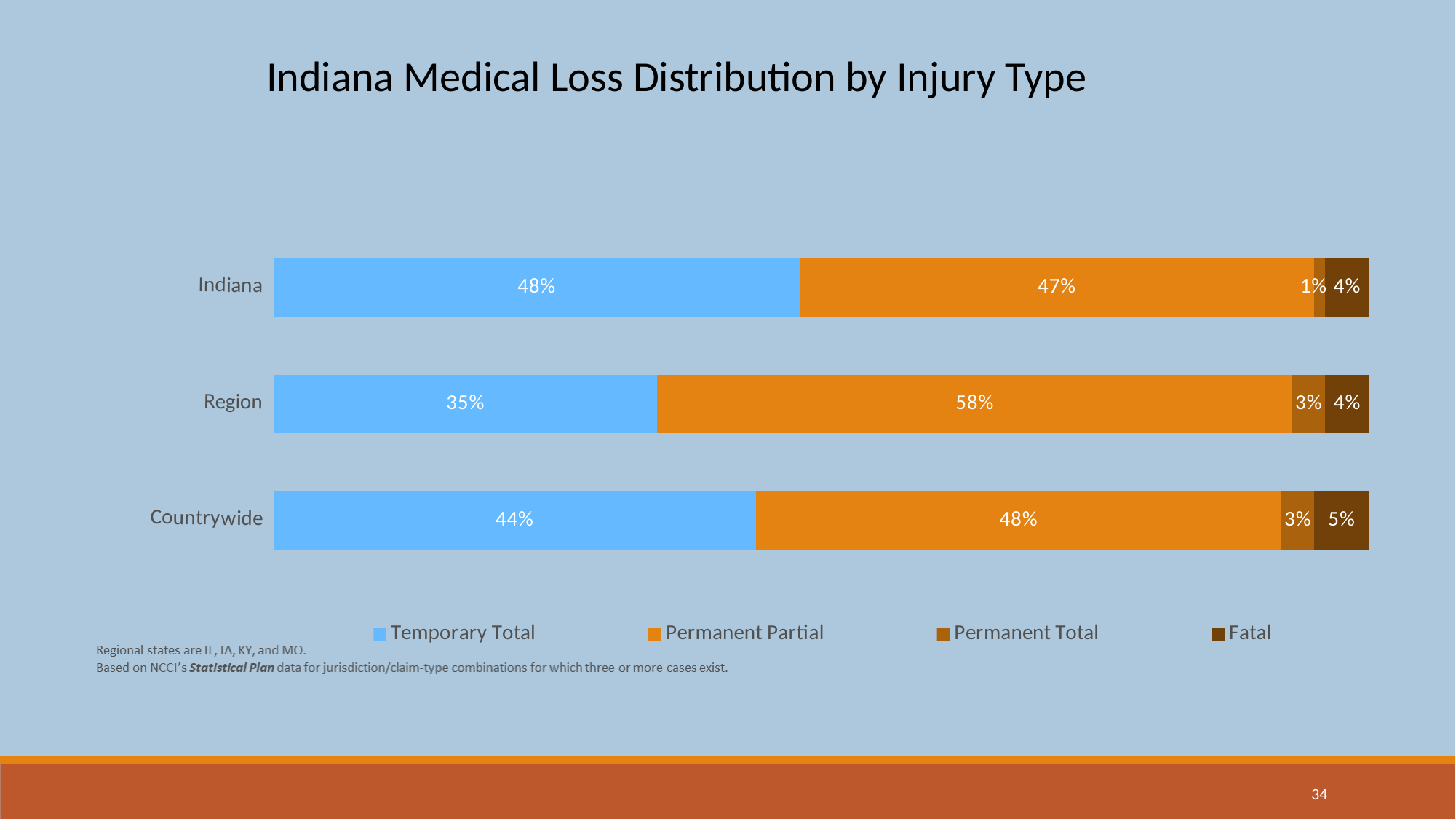
Which is larger, the Permanent Partial share for Indiana or for Countrywide? Countrywide What is the Temporary Total share for Indiana? 48% What is the difference between the Temporary Total shares for Indiana and Region? 13% What is the title of the chart? Indiana Medical Loss Distribution by Injury Type How many series does the legend list? 4 How many categories are shown on the chart? 3 What is the Fatal share for Countrywide? 5% What is the Permanent Partial share for Region? 58% Which category has the lowest Temporary Total share? Region What is the Permanent Total share for Indiana? 1% What kind of chart is shown on the slide? Stacked bar chart Which category has the highest Permanent Partial share? Region